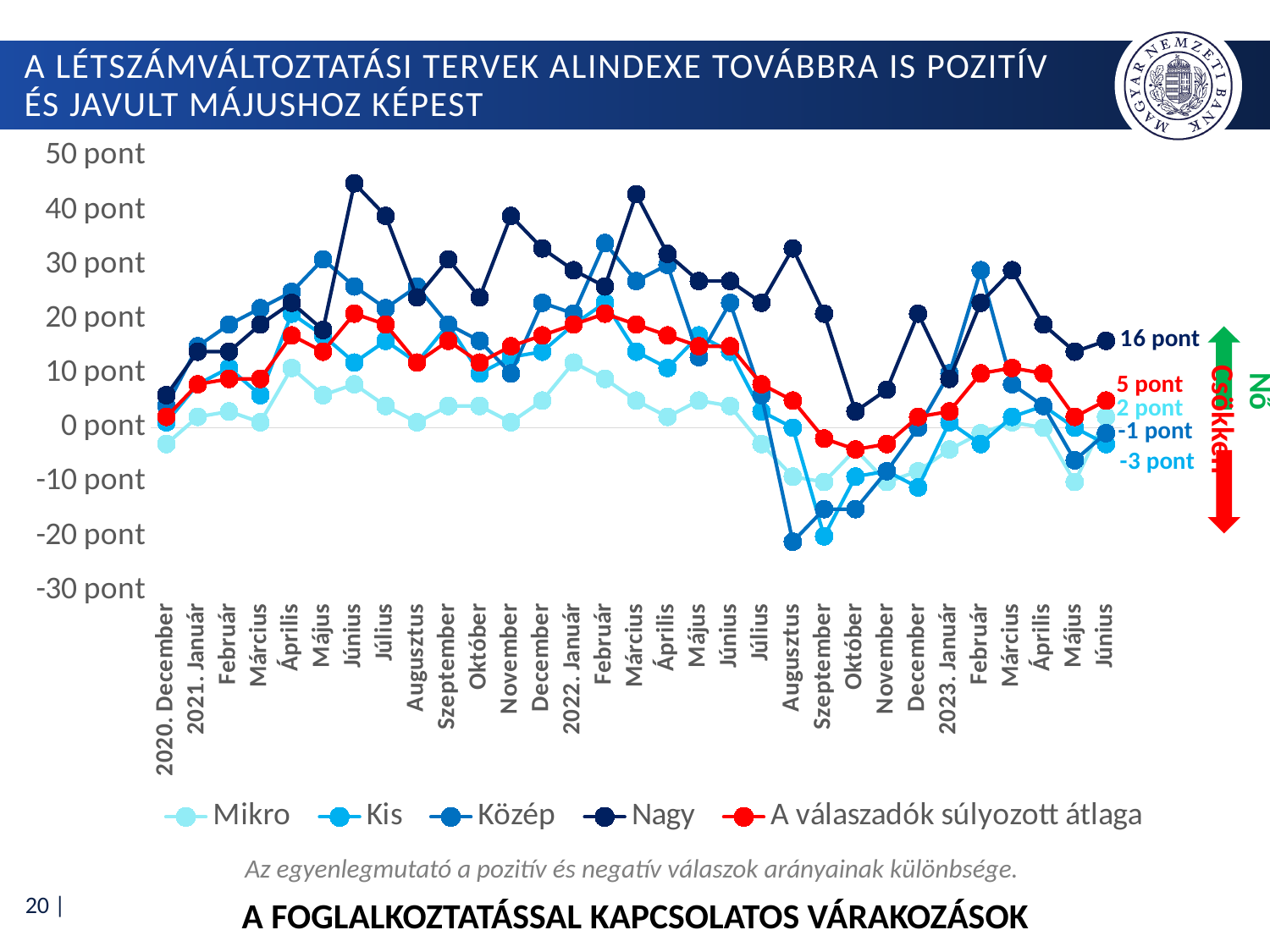
How many series does the legend list? 5 What is the value of 'A válaszadók súlyozott átlaga' at 2023 Június? 5 pont Is the value of the Nagy series at 2021 Június greater or less than 40 pont? greater Is the value of the Közép series at 2022 Augusztus greater or less than -10 pont? less What kind of chart is shown on the slide? line chart What is the value of the Közép series at 2023 Június? -1 pont What is the value of the Nagy series at 2023 Június? 16 pont What is the value of the Kis series at 2023 Június? -3 pont What is the value of the Mikro series at 2023 Június? 2 pont Which series has the highest value at 2023 Június? Nagy Which series has the lowest value at 2023 Június? Kis At 2023 Június, how much higher is the Nagy series than 'A válaszadók súlyozott átlaga'? 11 pont